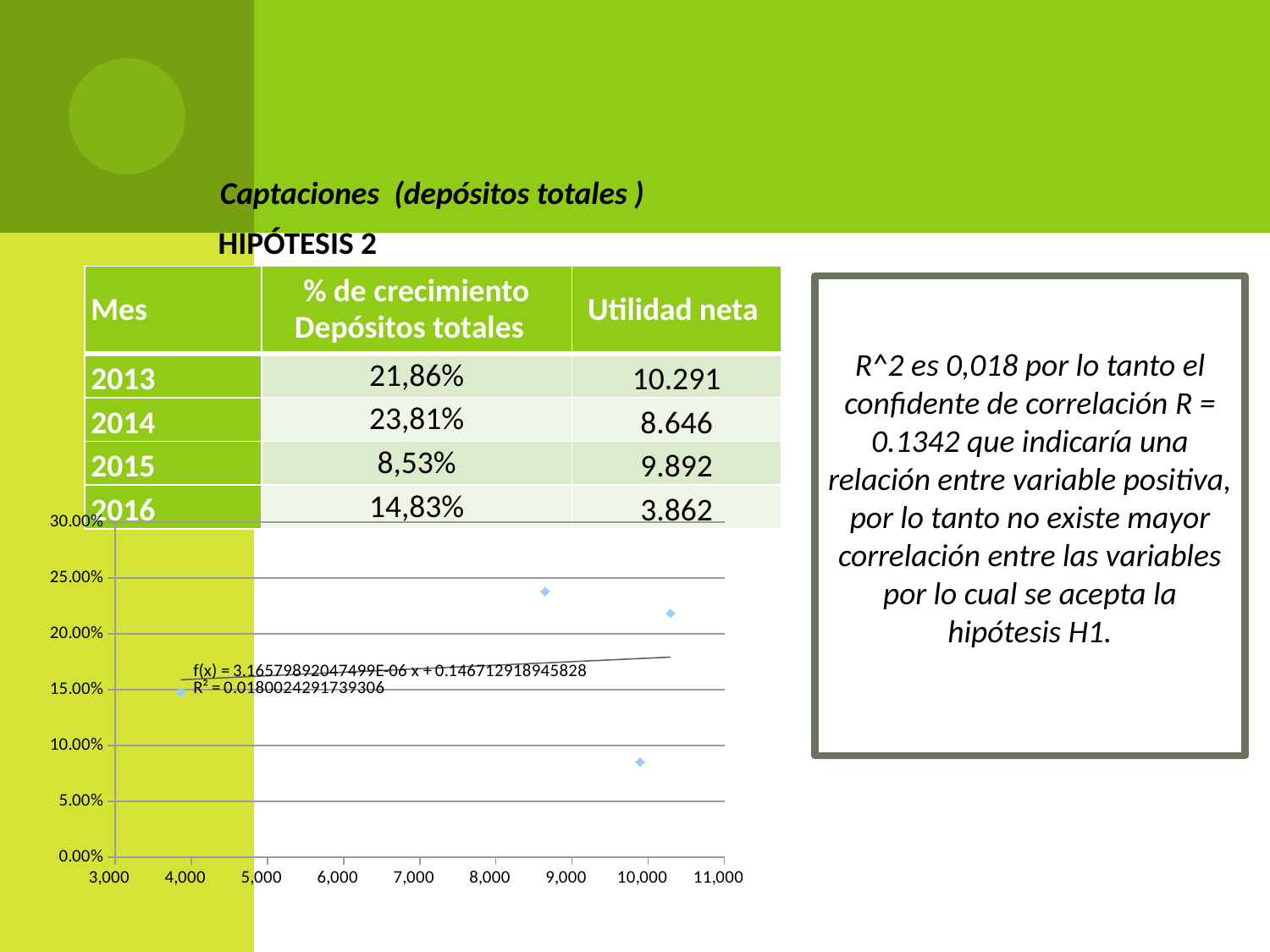
What is the lowest value shown on the chart's horizontal axis? 3,000 How many data points are plotted on the scatter chart? 4 What R² value is printed on the chart? R² = 0.0180024291739306 What kind of chart is shown on the slide? scatter chart What is the highest value shown on the chart's vertical axis? 30.00% Does the trendline on the chart rise or fall as x increases? rise Is the y value of the point plotted near x = 10,000 greater or less than 10.00%? less Is the y value of the point plotted near x = 10,300 greater or less than 20.00%? greater Which has the lower y value on the chart: the point near x = 4,000 or the point near x = 10,000? the point near x = 10,000 Which has the higher y value on the chart: the point near x = 8,600 or the point near x = 10,000? the point near x = 8,600 Is the y value of the point plotted near x = 8,600 greater or less than 20.00%? greater What is the highest value shown on the chart's horizontal axis? 11,000